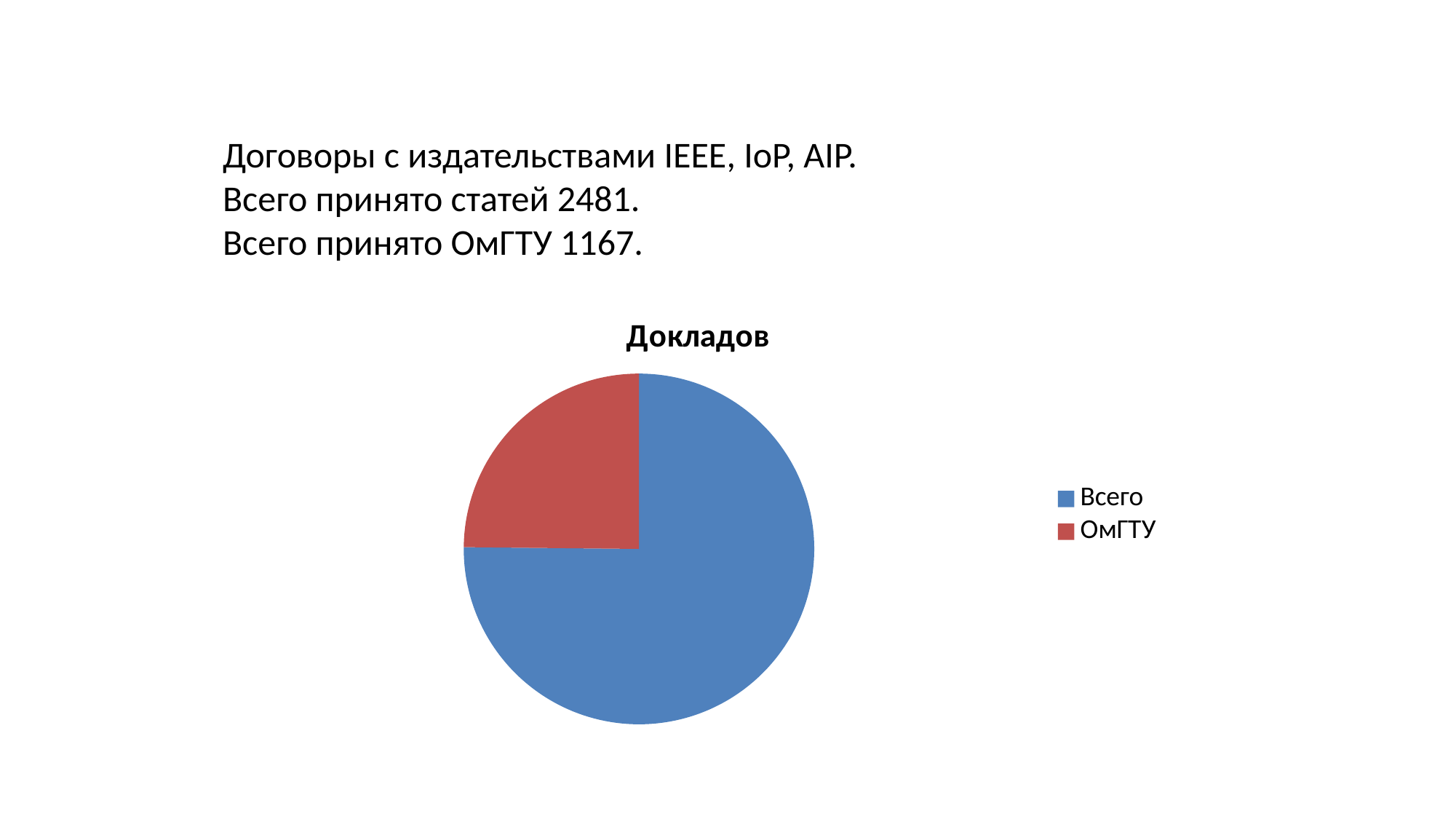
Which slice is larger in the pie chart, Всего or ОмГТУ? Всего What is the title of the pie chart? Докладов How many slices does the pie chart have? 2 How many entries does the legend of the pie chart list? 2 What colour is the ОмГТУ slice in the pie chart? red What kind of chart is shown on the slide? pie chart Which slice of the pie chart is the largest? Всего Which slice of the pie chart is the smallest? ОмГТУ